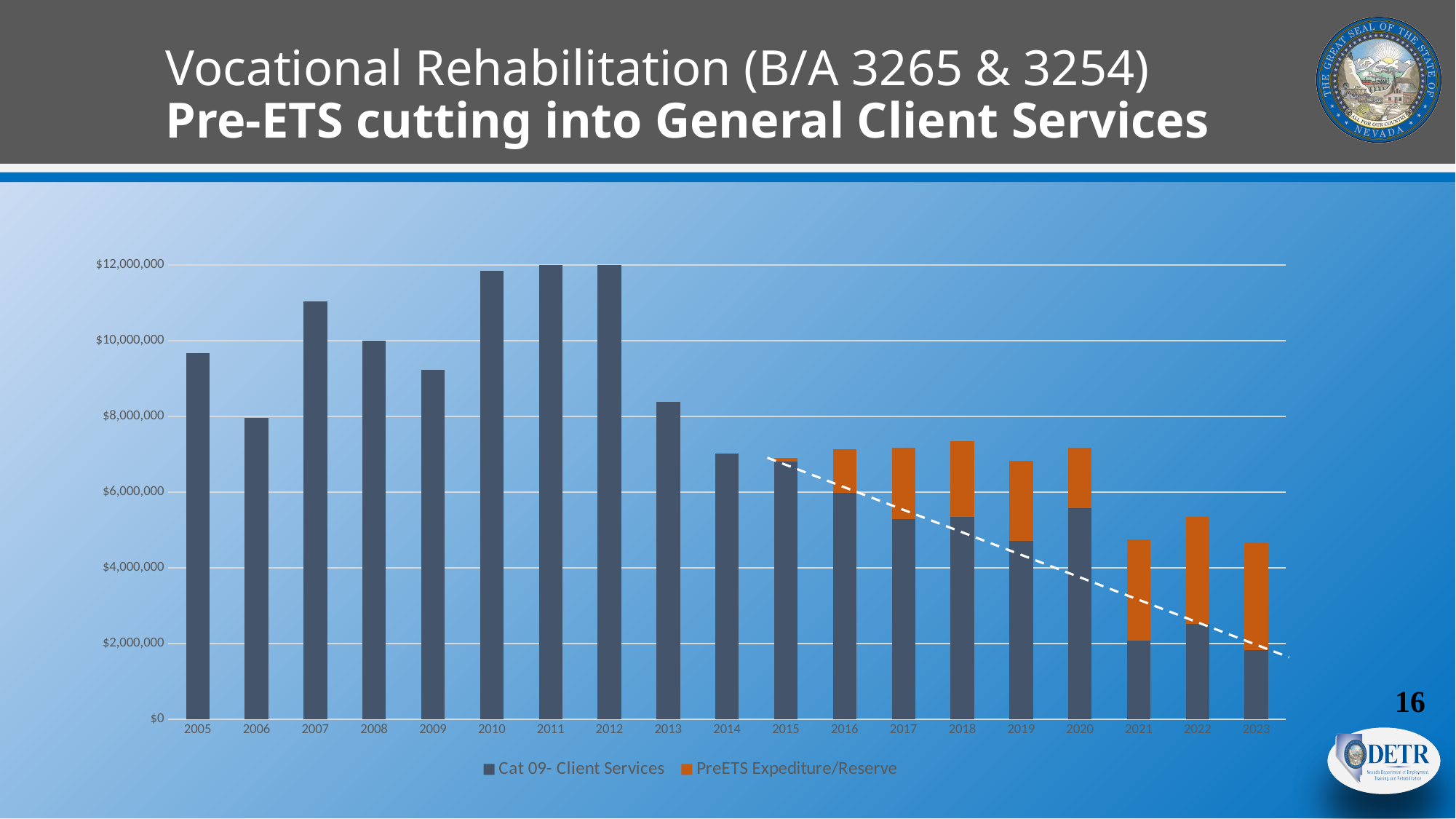
Is the Cat 09- Client Services value for 2022 greater or less than $2,000,000? greater Which year has the larger Cat 09- Client Services value, 2009 or 2010? 2010 Which year has the larger Cat 09- Client Services value, 2005 or 2006? 2005 Is the Cat 09- Client Services value for 2005 greater or less than $8,000,000? greater What type of chart is shown on the slide? bar chart In which year does the PreETS Expediture/Reserve series first appear on the chart? 2015 Does the Cat 09- Client Services value rise or fall from 2014 to 2023? fall How many series does the legend list? 2 What are the two series named in the legend? Cat 09- Client Services and PreETS Expediture/Reserve How many years are shown along the x axis? 19 Is the Cat 09- Client Services value for 2021 greater or less than $4,000,000? less